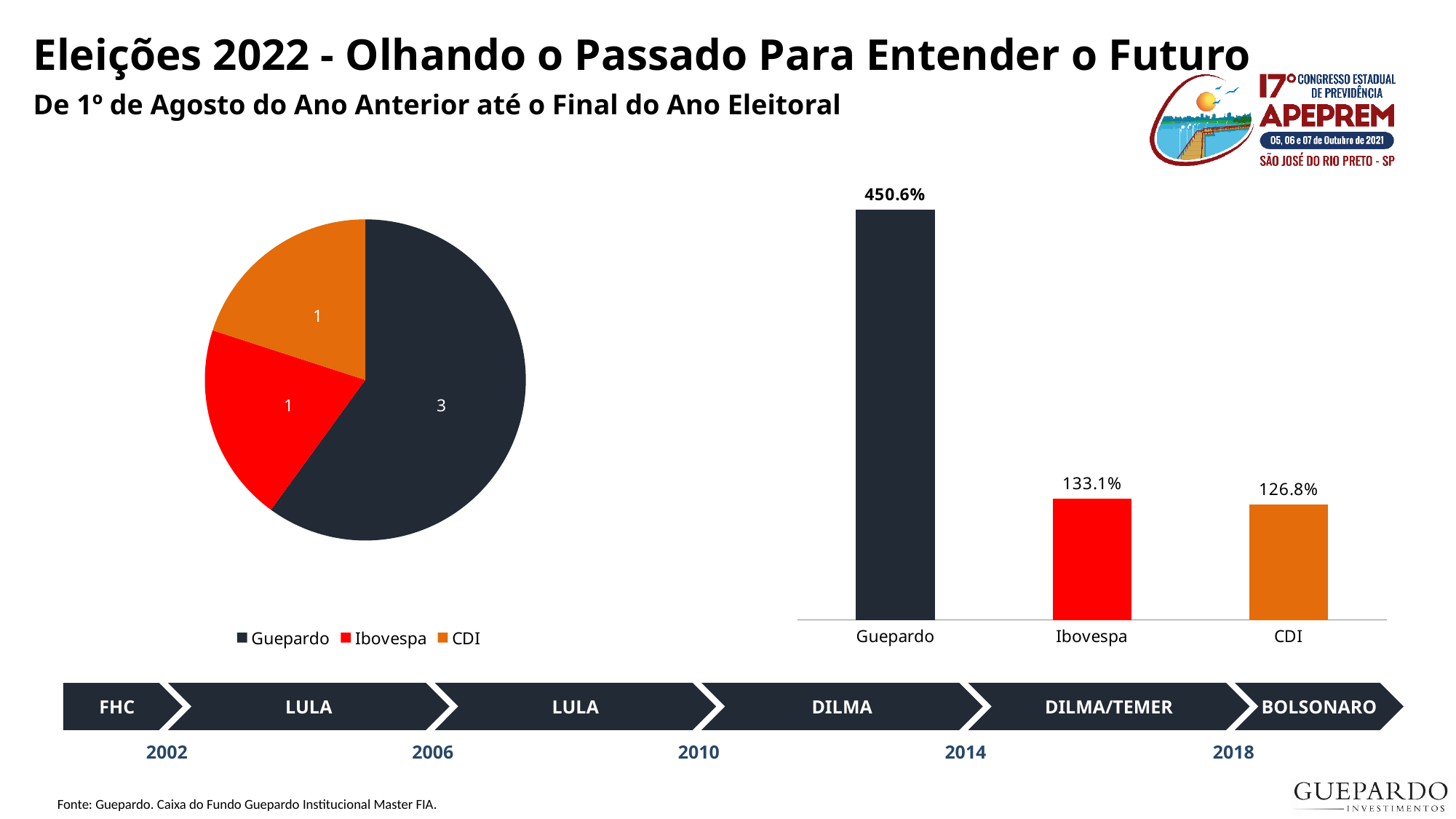
In the bar chart on the right, how many bars are plotted? 3 In the bar chart on the right, which category has the highest value? Guepardo In the bar chart on the right, what is the value for Guepardo? 450.6% In the bar chart on the right, what is the difference between the Ibovespa and CDI values? 6.3% In the bar chart on the right, which category has the lowest value? CDI How many entries does the legend of the pie chart on the left list? 3 In the bar chart on the right, what is the difference between the Guepardo and Ibovespa values? 317.5% In the bar chart on the right, what is the value for Ibovespa? 133.1% In the bar chart on the right, what is the value for CDI? 126.8% In the pie chart on the left, what share of the total does the Guepardo slice represent? 60% In the pie chart on the left, what is the value shown for the Guepardo slice? 3 What kind of chart is the chart on the left of the slide? Pie chart